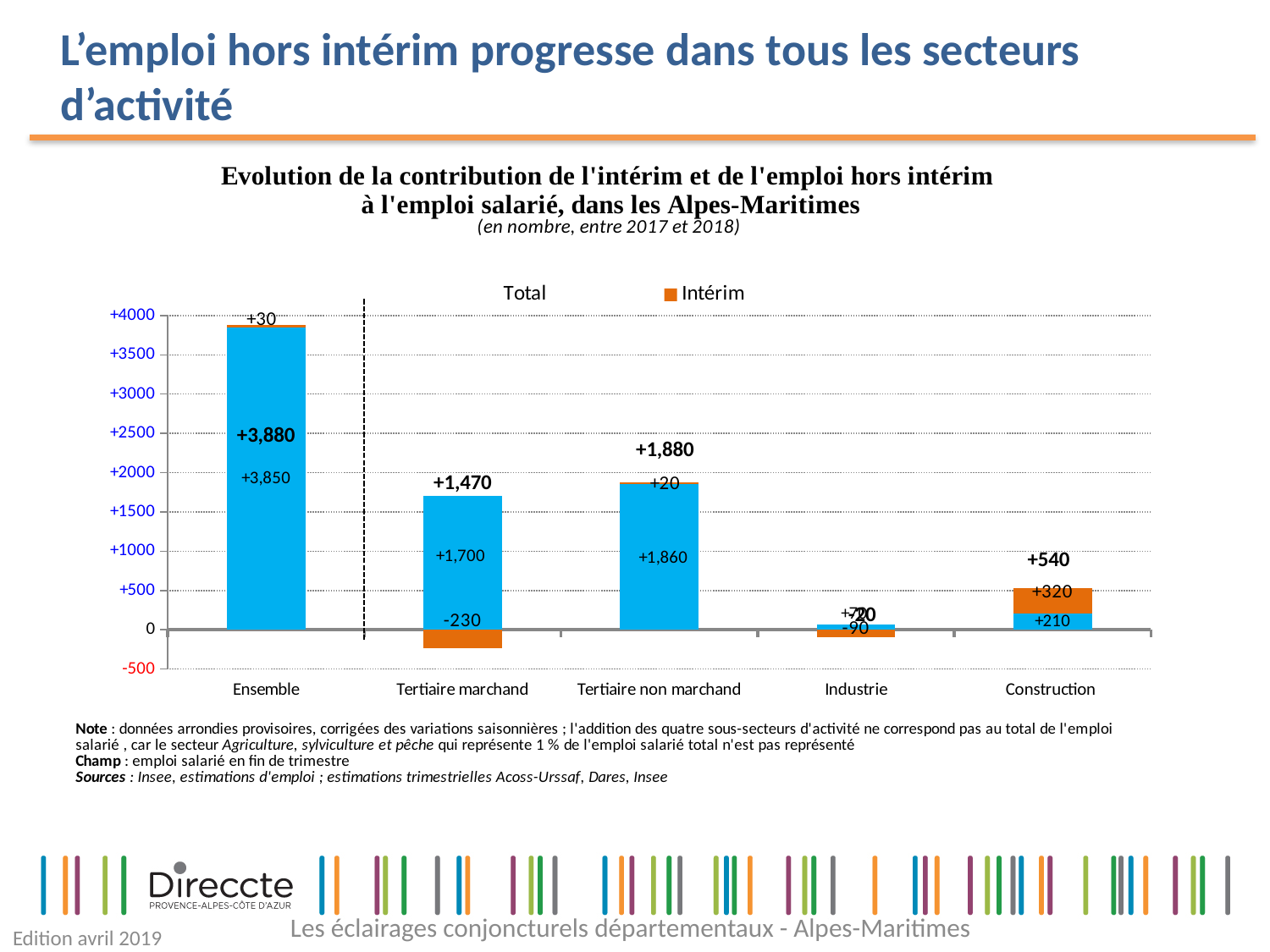
Which has the larger Intérim value, Construction or Tertiaire non marchand? Construction What is the Intérim value for Construction? +320 What is the total value labelled above the bar for Ensemble? +3,880 Which category has the highest total value? Ensemble Which category has the lowest total value? Industrie What is the value of the blue segment for Tertiaire marchand? +1,700 How many sector categories are shown on the x axis of the chart? 5 What is the Intérim value for Tertiaire marchand? -230 What is the difference between the total for Tertiaire non marchand and the total for Tertiaire marchand? 410 What kind of chart is shown on the slide? bar chart What is the Intérim value for Ensemble? +30 Which entries are listed in the chart legend? Total and Intérim